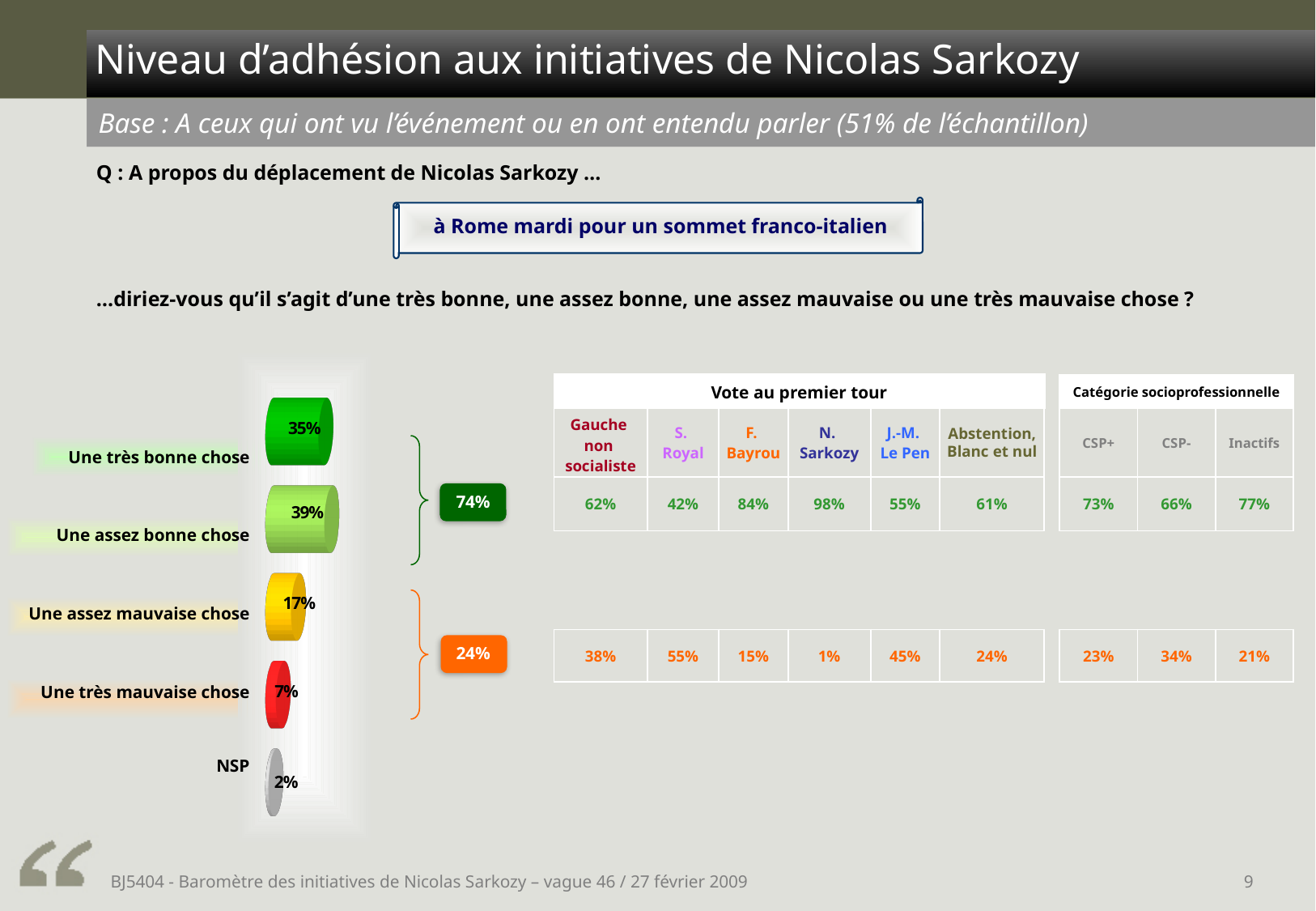
What is the value for "Une très bonne chose"? 35% Which category has the lowest value in the chart? NSP What is the value for "NSP"? 2% What kind of chart is shown on the slide? Bar chart Which category has the highest value in the chart? Une assez bonne chose What is the difference between "Une assez bonne chose" and "Une très bonne chose"? 4% What is the value for "Une assez mauvaise chose"? 17% What is the value for "Une très mauvaise chose"? 7% What is the difference between "Une assez mauvaise chose" and "Une très mauvaise chose"? 10% What is the value for "Une assez bonne chose"? 39% Which is larger, the value for "Une très bonne chose" or the value for "Une assez mauvaise chose"? Une très bonne chose How many categories are shown in the chart? 5